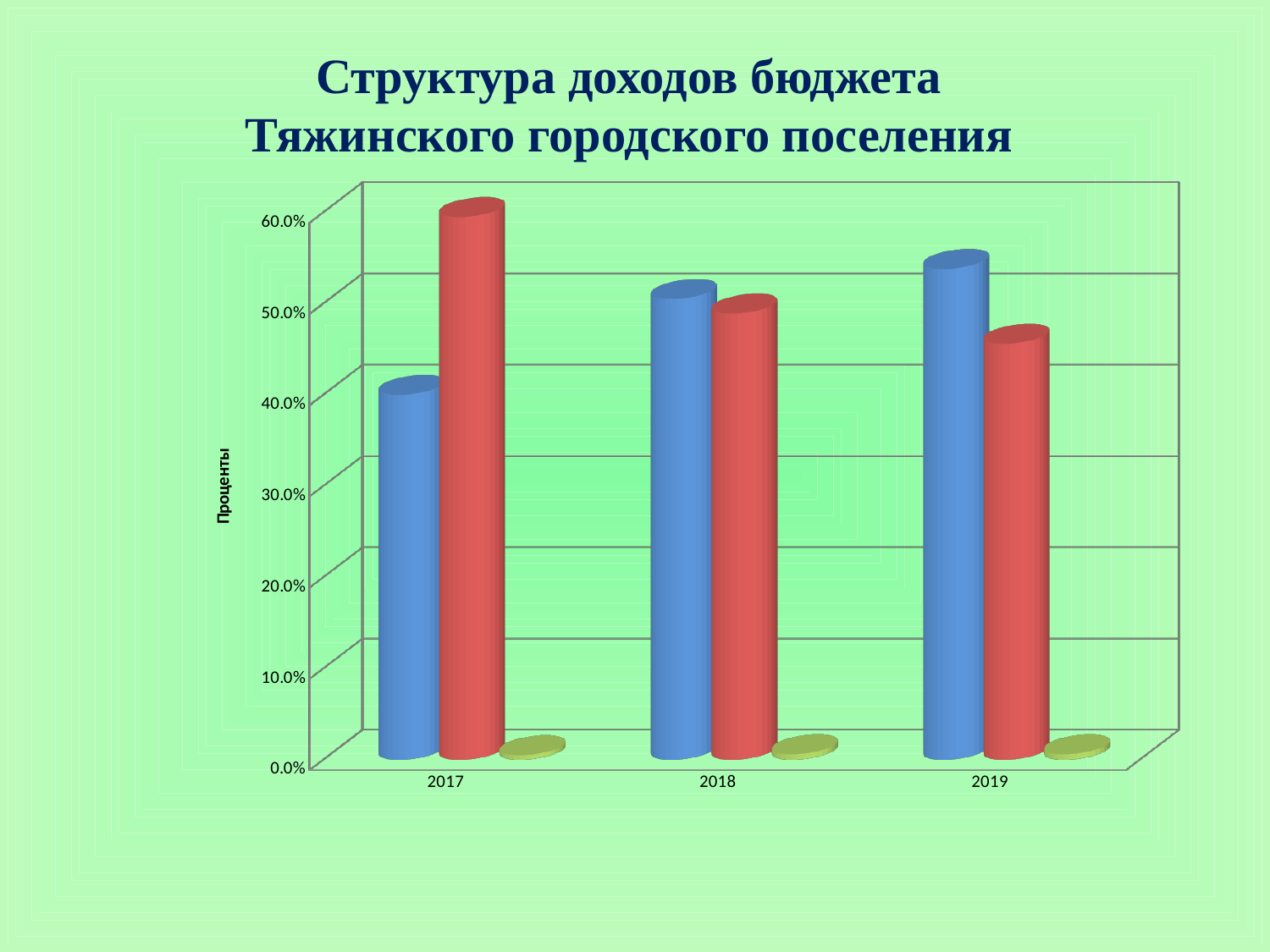
In which year is the red bar the tallest? 2017 Is the value of the red bar for 2017 greater or less than 50.0%? greater Is the value of the blue bar for 2017 greater or less than 50.0%? less What is the title of the chart on the slide? Структура доходов бюджета Тяжинского городского поселения In 2019, which bar is taller, the blue one or the red one? blue Do the values of the blue bars rise or fall from 2017 to 2019? rise Is the value of the blue bar for 2019 greater or less than 50.0%? greater What is the label of the vertical axis? Проценты What kind of chart is shown on the slide? bar chart How many years are shown on the x axis of the chart? 3 In 2017, which bar is taller, the blue one or the red one? red